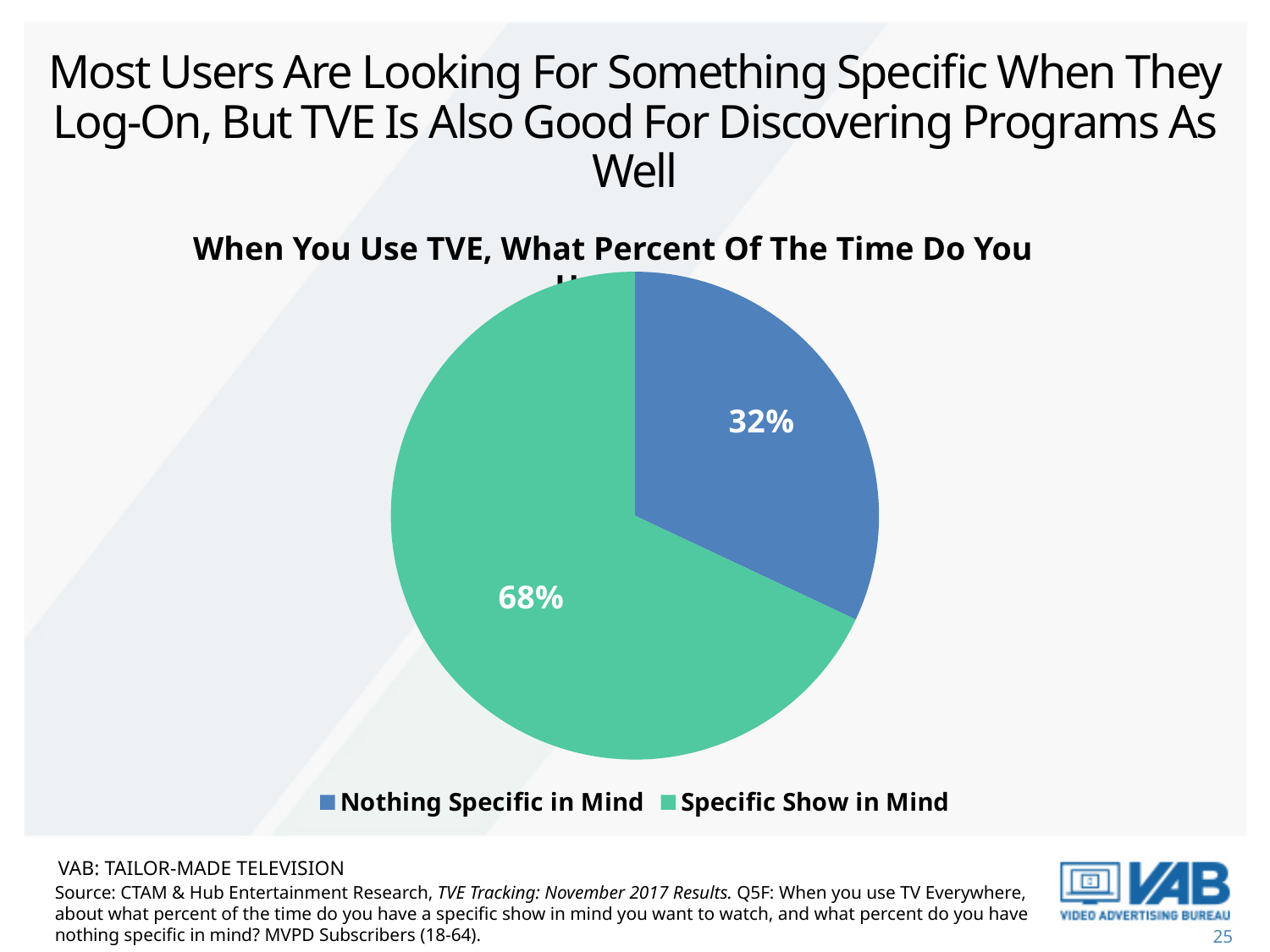
What colour is the Nothing Specific in Mind slice? blue What colour is the Specific Show in Mind slice? green What is the difference in percentage points between Specific Show in Mind and Nothing Specific in Mind? 36 What percentage of the time do users have a specific show in mind? 68% How many entries does the legend list? 2 Which is larger: Nothing Specific in Mind or Specific Show in Mind? Specific Show in Mind How many slices does the pie chart have? 2 Which slice of the pie is the smallest? Nothing Specific in Mind What percentage of the time do users have nothing specific in mind? 32% What share of the pie does the Nothing Specific in Mind slice represent? 32% Which slice of the pie is the largest? Specific Show in Mind What type of chart is shown on the slide? pie chart